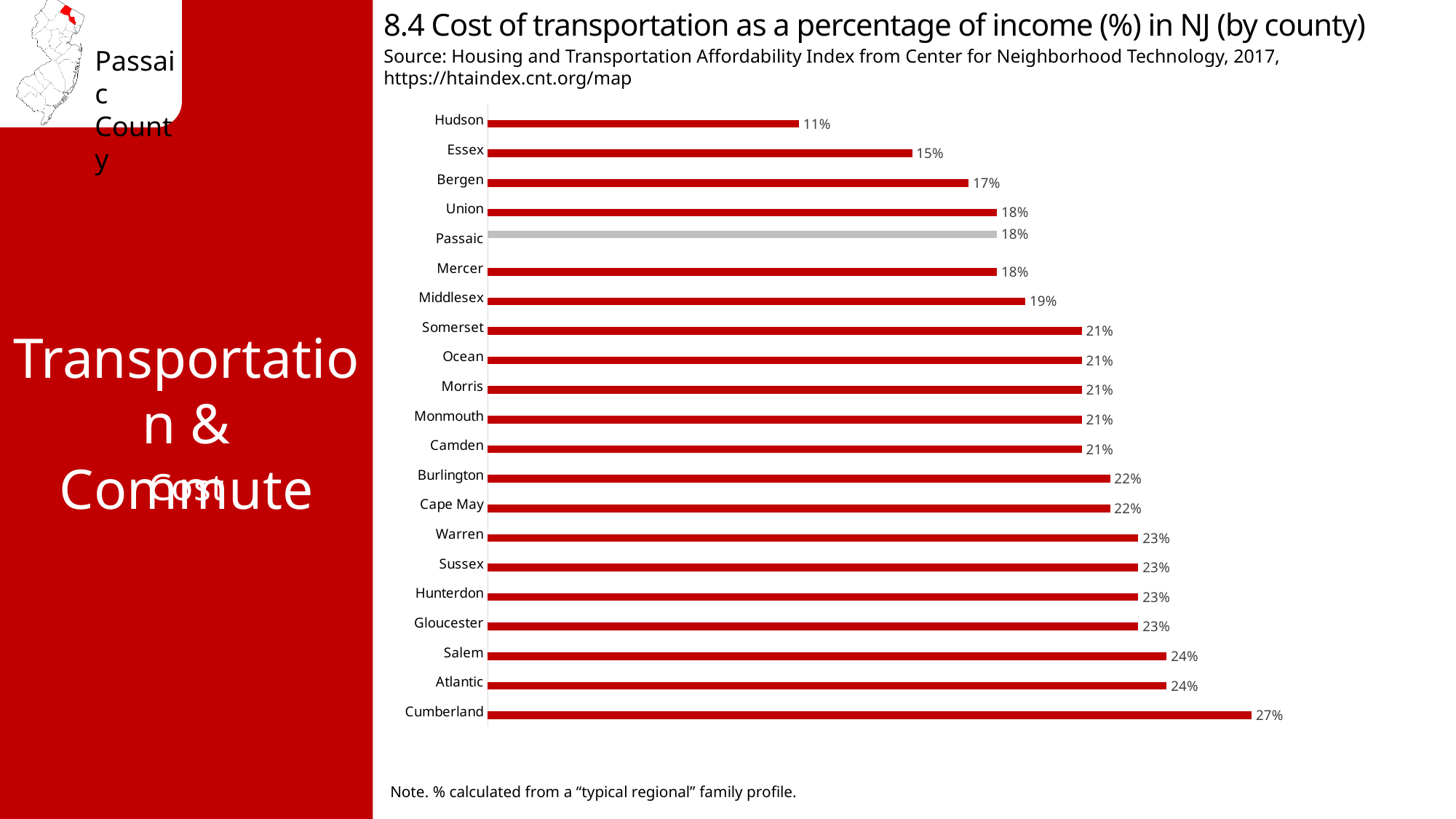
What is the cost of transportation as a percentage of income for Passaic County? 18% What is the difference in percentage points between Essex and Bergen? 2 How many counties are shown in the chart? 21 Which county has a higher cost of transportation as a percentage of income, Salem or Somerset? Salem What is the cost of transportation as a percentage of income for Cape May County? 22% What is the cost of transportation as a percentage of income for Middlesex County? 19% What is the difference in percentage points between Cumberland and Hudson? 16 What type of chart is used on this slide? Bar chart Which county has the highest cost of transportation as a percentage of income? Cumberland Which county's bar is shown in grey instead of red? Passaic What is the cost of transportation as a percentage of income for Hudson County? 11% Which county has the lowest cost of transportation as a percentage of income? Hudson